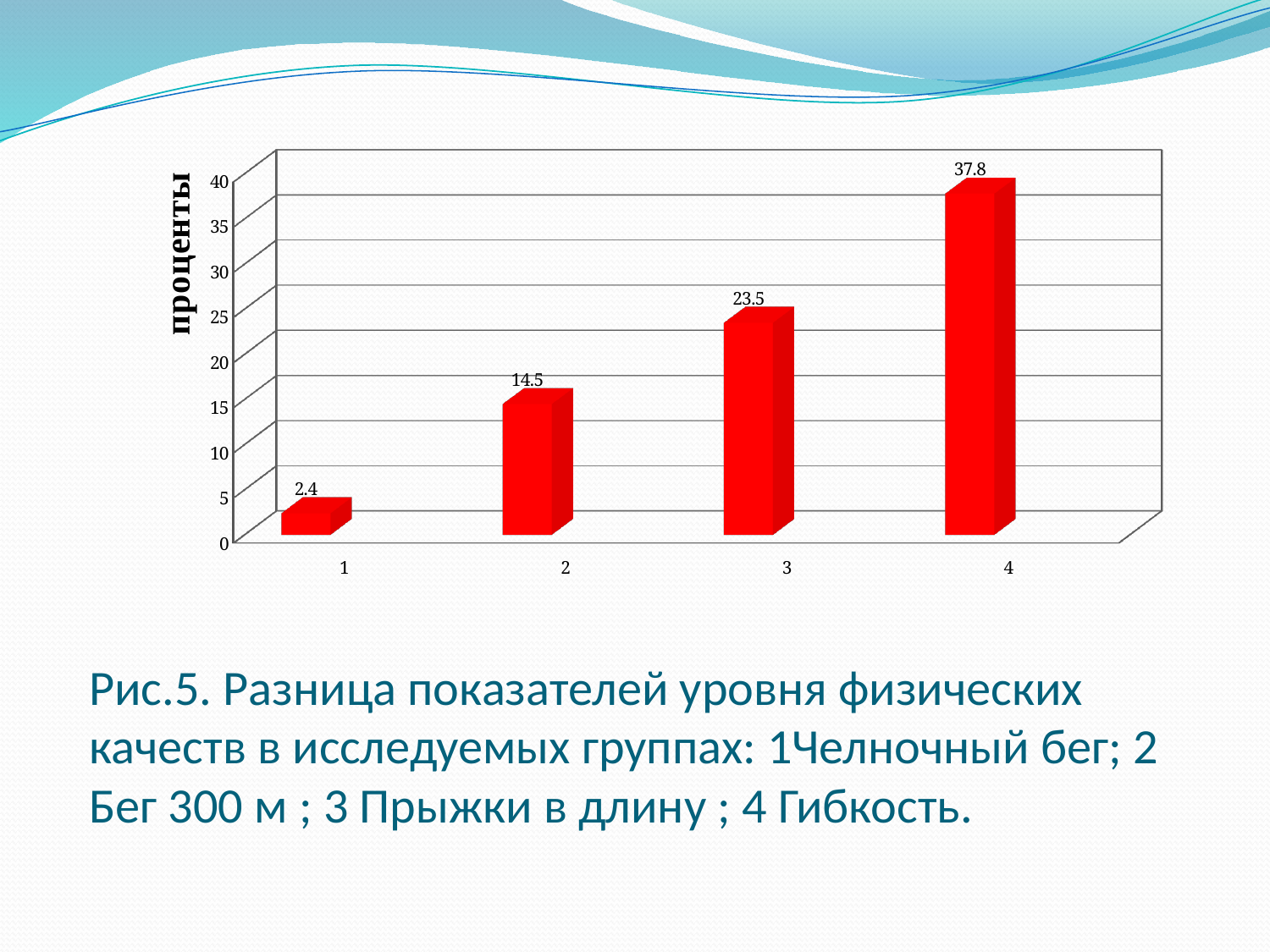
Which is larger, the value for category 2 or the value for category 3? 3 What is the value for category 1? 2.4 Which category has the highest value? 4 How many bars are shown in the chart? 4 Do the values rise or fall from category 1 to category 4? rise What is the difference between the values for category 4 and category 3? 14.3 Which category has the lowest value? 1 What is the value for category 4? 37.8 What kind of chart is shown on the slide? bar chart What is the difference between the values for category 2 and category 1? 12.1 What is the value for category 3? 23.5 What is the value for category 2? 14.5